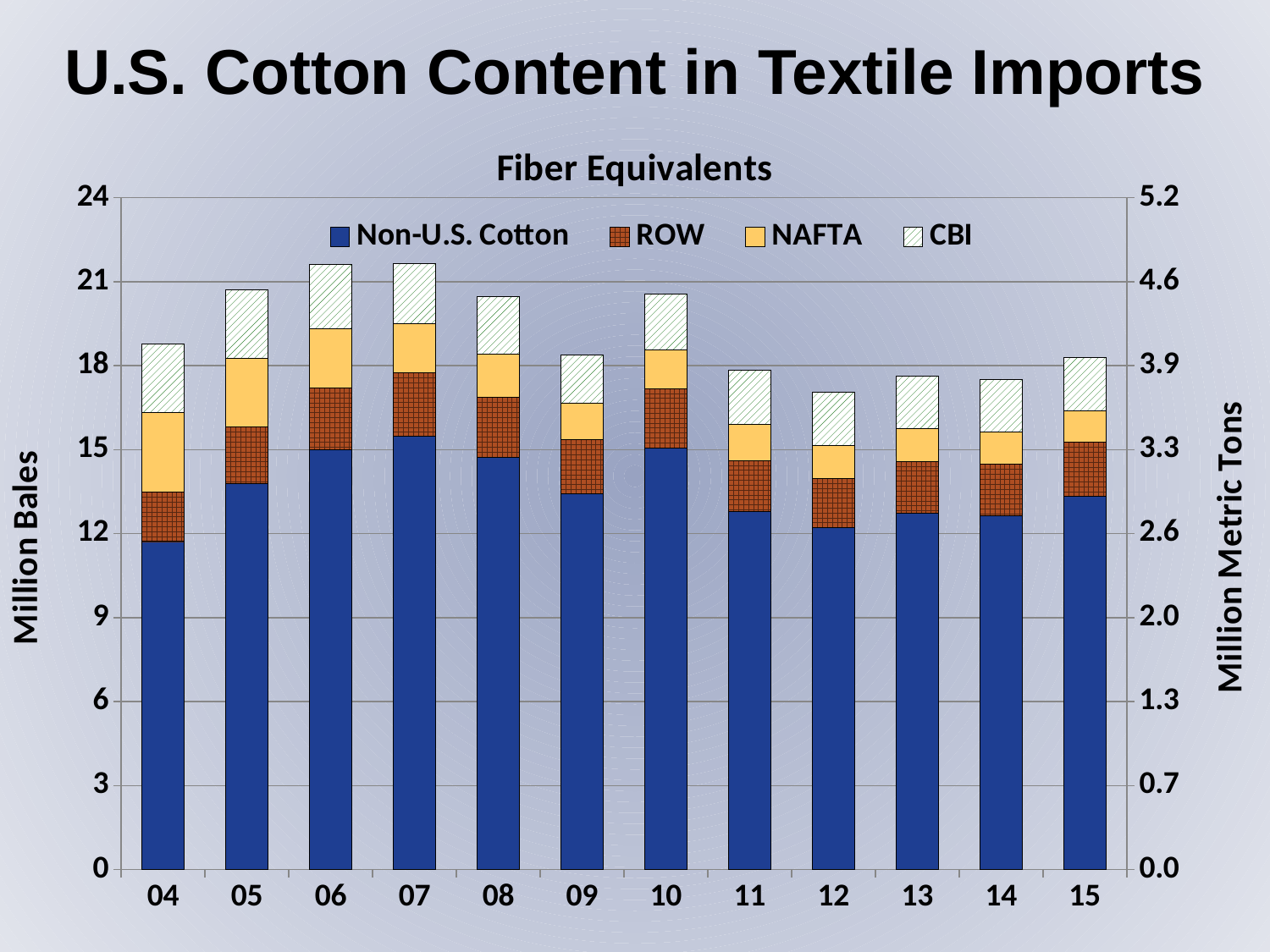
Which year has the lowest Non-U.S. Cotton value? 04 Which year has the taller total stacked bar, 04 or 05? 05 What kind of chart is shown on the slide? Stacked bar chart Is the total stacked bar for 12 greater or less than 18 million bales? less What is the label of the left vertical axis? Million Bales Is the Non-U.S. Cotton value for 07 greater or less than 15 million bales? greater How many series does the legend list? 4 Is the total stacked bar for 06 greater or less than 21 million bales? greater Which year has the taller total stacked bar, 10 or 11? 10 How many years are shown along the x axis? 12 Do the total stacked bars rise or fall from 10 to 12? fall